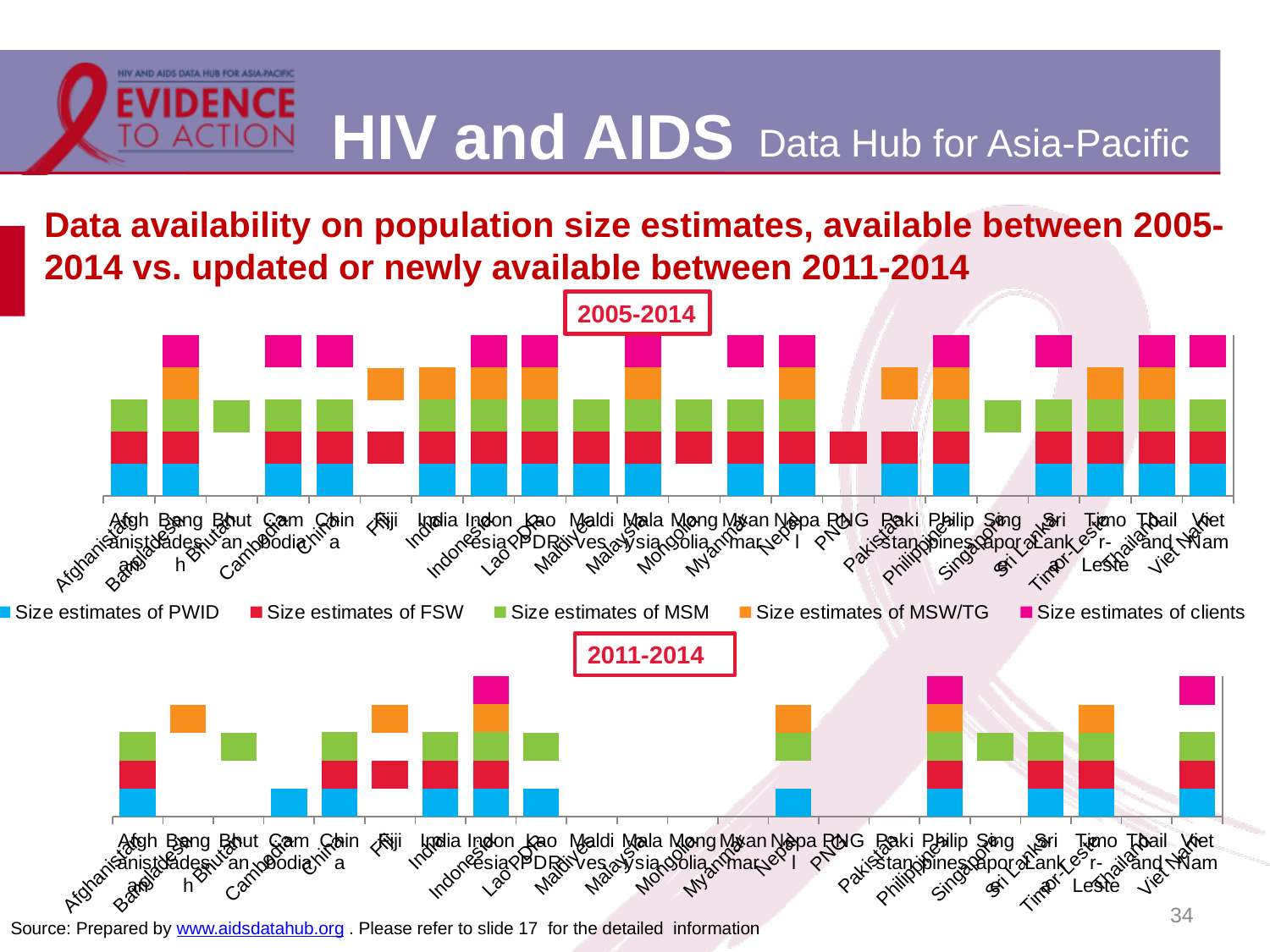
What kind of chart is the 2005-2014 chart? Stacked bar chart How many countries are shown along the x axis of the 2005-2014 chart? 22 What is the title of the top chart? 2005-2014 In the 2011-2014 chart, which bar is taller, Philippines or Fiji? Philippines In the 2005-2014 chart, which bar is taller, Sri Lanka or Singapore? Sri Lanka How many countries are shown along the x axis of the 2011-2014 chart? 22 In the 2005-2014 chart, which bar is taller, Bangladesh or Bhutan? Bangladesh Which series is shown in blue in the legend? Size estimates of PWID How many series does the legend list? 5